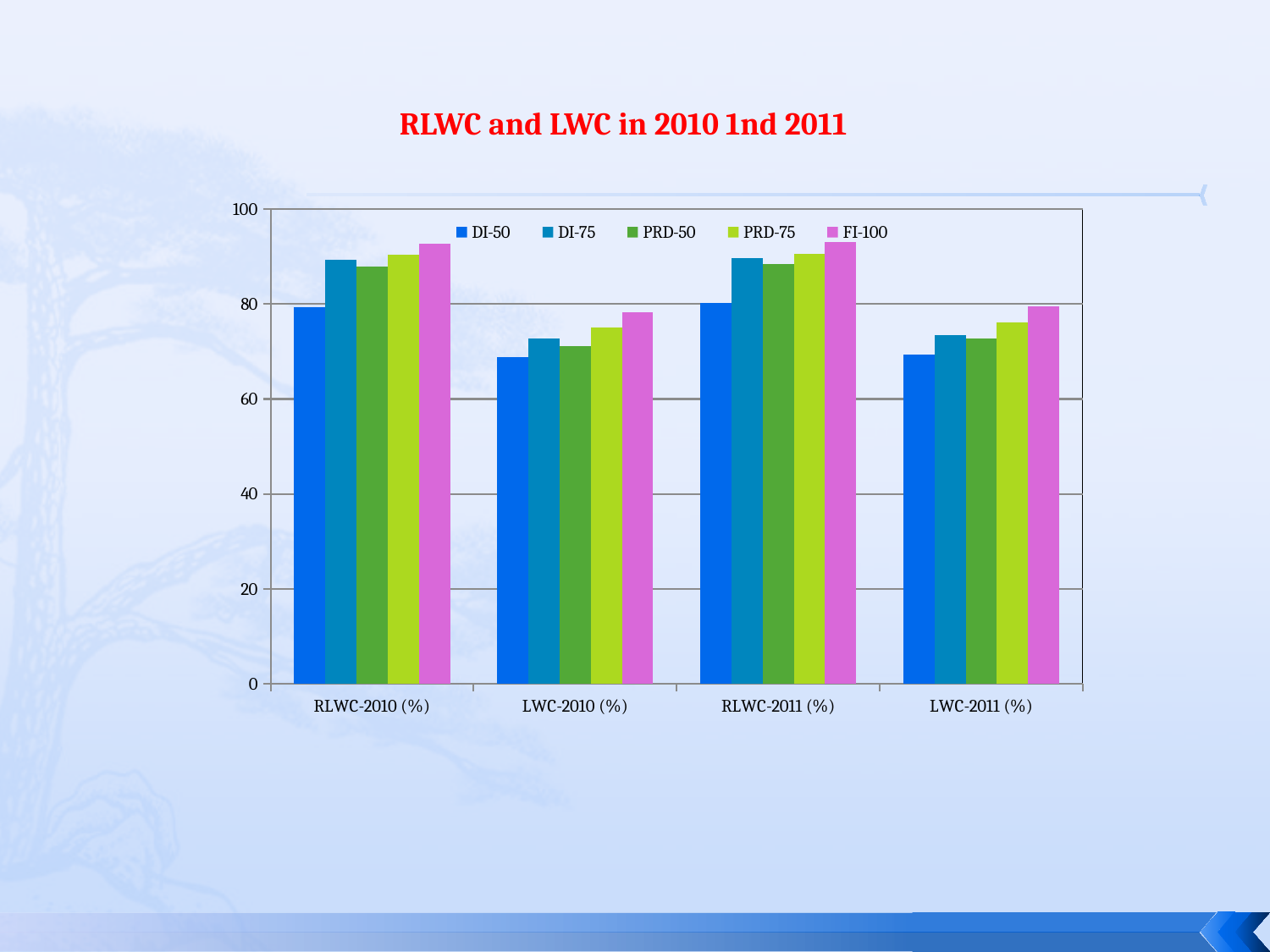
Which is larger, the DI-50 value for RLWC-2010 (%) or the DI-50 value for LWC-2010 (%)? RLWC-2010 (%) What kind of chart is shown on the slide? Bar chart What is the title of the chart? RLWC and LWC in 2010 1nd 2011 How many categories are shown on the x axis? 4 Is the value for FI-100 in RLWC-2011 (%) greater or less than 80? greater Is the value for DI-50 in LWC-2010 (%) greater or less than 80? less How many series does the legend list? 5 Which series is shown in pink in the legend? FI-100 Which series has the highest value in the LWC-2010 (%) category? FI-100 Is the value for DI-50 in RLWC-2010 (%) greater or less than 60? greater Which series has the lowest value in the LWC-2011 (%) category? DI-50 Which is larger in the LWC-2011 (%) category, PRD-75 or DI-75? PRD-75